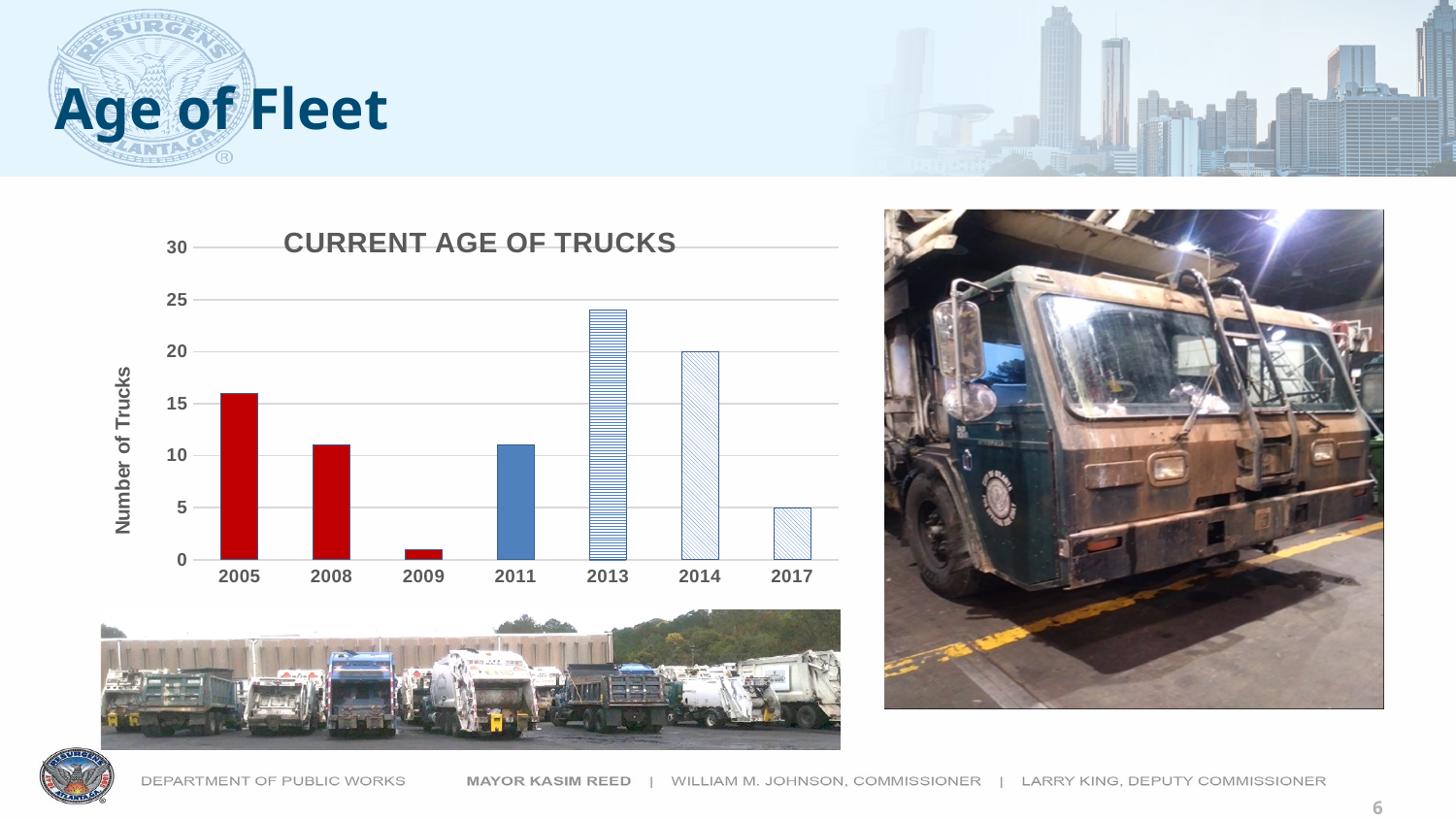
Which year has more trucks, 2014 or 2017? 2014 Is the number of trucks for 2008 greater or less than 10? greater Is the number of trucks for 2013 greater or less than 20? greater Which year has the highest number of trucks in the chart? 2013 Is the number of trucks for 2005 greater or less than 15? greater What is the label of the vertical axis of the chart? Number of Trucks How many year categories are shown on the x axis of the chart? 7 Which year has the lowest number of trucks in the chart? 2009 Which year has more trucks, 2005 or 2008? 2005 What is the title of the chart on the slide? CURRENT AGE OF TRUCKS What kind of chart is shown on the slide? bar chart